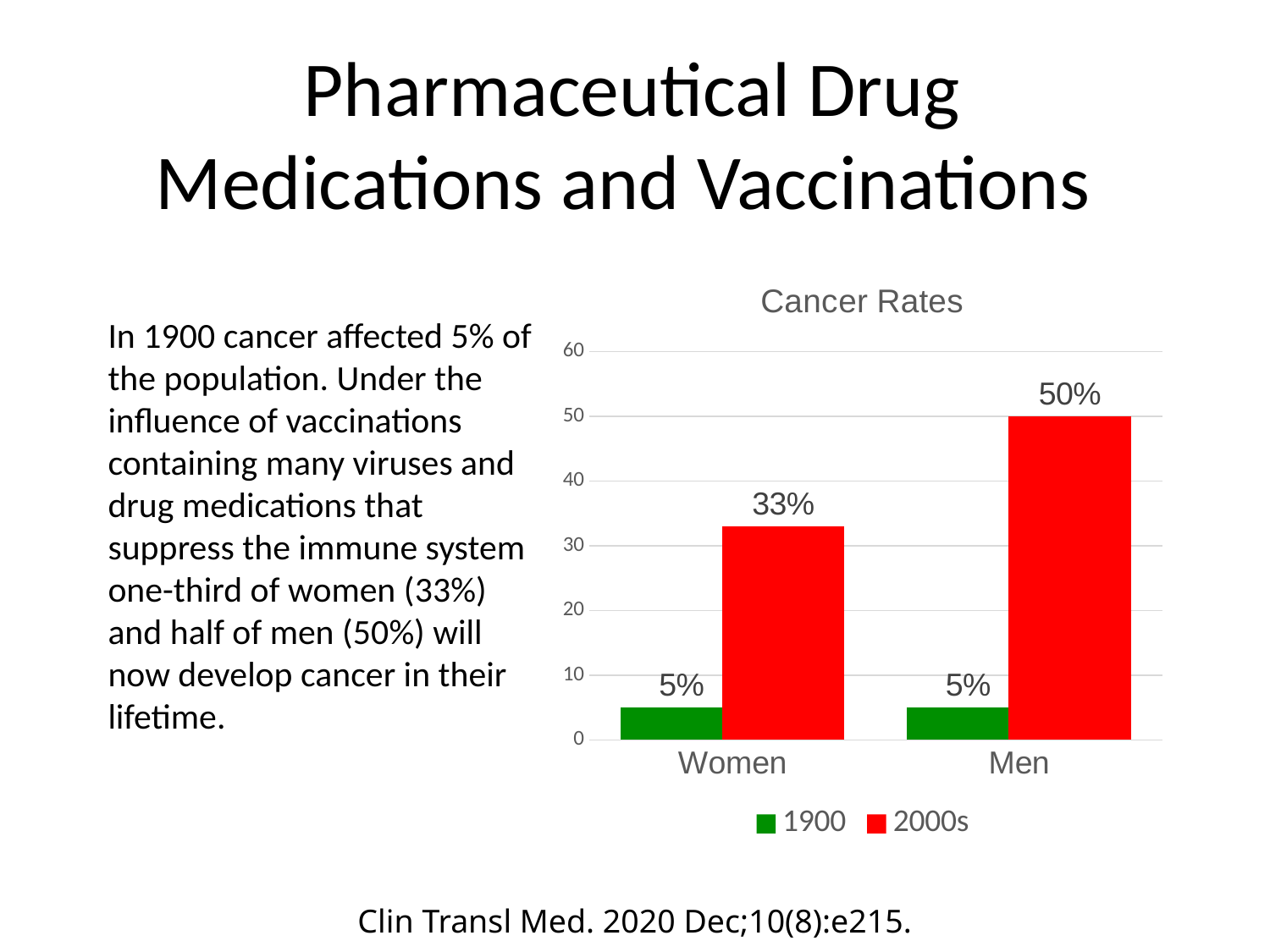
What is the value for Women in the 1900 series? 5% What kind of chart is shown? Bar chart What is the value for Women in the 2000s series? 33% What is the difference between the 2000s values for Men and Women? 17% How many series does the legend list? 2 Which category has the highest value in the 2000s series? Men What is the value for Men in the 2000s series? 50% What is the difference between the 2000s and 1900 values for Women? 28% What is the title of the chart? Cancer Rates What colour are the bars for the 1900 series? Green Which is larger for Men: the 1900 value or the 2000s value? 2000s How many categories are shown on the x axis? 2